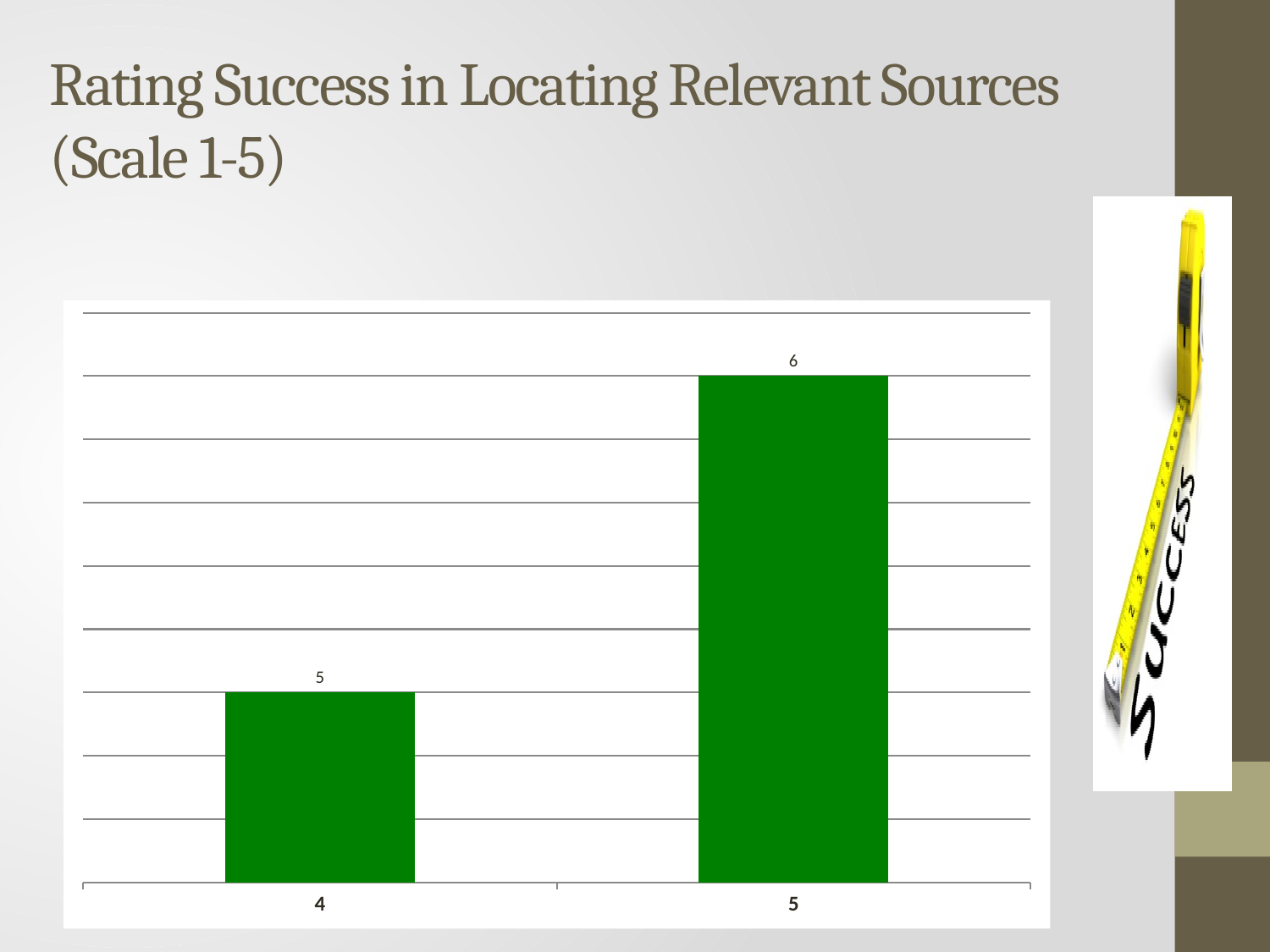
What kind of chart is shown on the slide? Bar chart What colour are the bars in the chart? Green What is the value for category 4? 5 Do the values rise or fall from category 4 to category 5? Rise What is the total of the two bar values? 11 How many categories are shown on the x axis? 2 What is the title of the slide containing the chart? Rating Success in Locating Relevant Sources (Scale 1-5) What is the value for category 5? 6 What is the difference between the values for category 5 and category 4? 1 Which category has the highest value? 5 Which is larger, the value for category 4 or the value for category 5? The value for category 5 Which category has the lowest value? 4